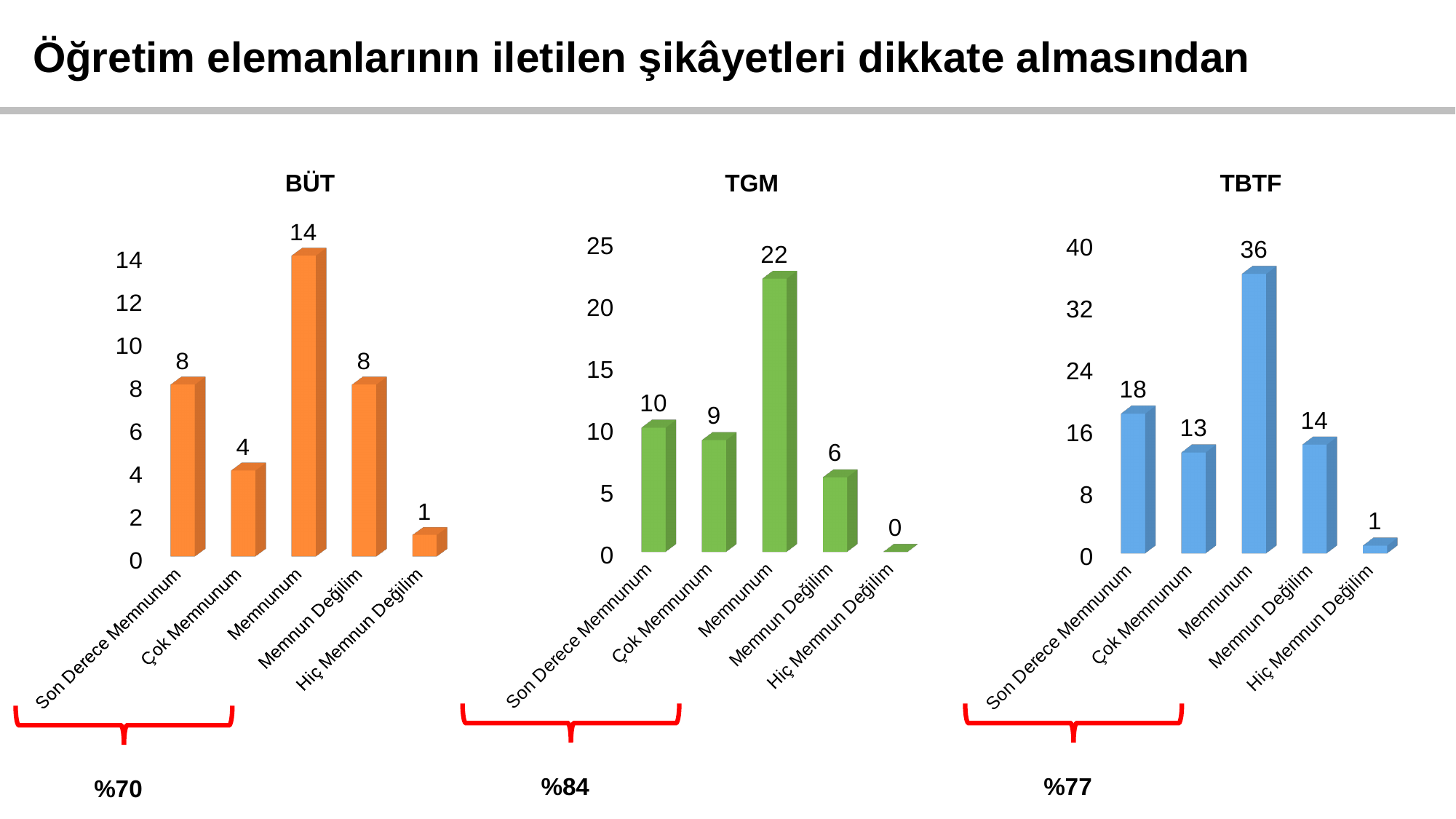
How many categories does the BÜT chart show? 5 What colour are the bars in the TBTF chart? blue In the BÜT chart, what is the difference between the values for Memnunum and Çok Memnunum? 10 In the BÜT chart, what is the value for Memnunum? 14 In the TGM chart, what is the value for Hiç Memnun Değilim? 0 In the TGM chart, which is larger, the value for Son Derece Memnunum or the value for Çok Memnunum? Son Derece Memnunum In the TBTF chart, what is the value for Son Derece Memnunum? 18 In the TBTF chart, which category has the highest value? Memnunum What kind of chart is the TGM chart? bar chart In the TGM chart, which category has the lowest value? Hiç Memnun Değilim What percentage is shown below the bracket under the TGM chart? %84 In the TBTF chart, what is the difference between the values for Memnunum and Memnun Değilim? 22